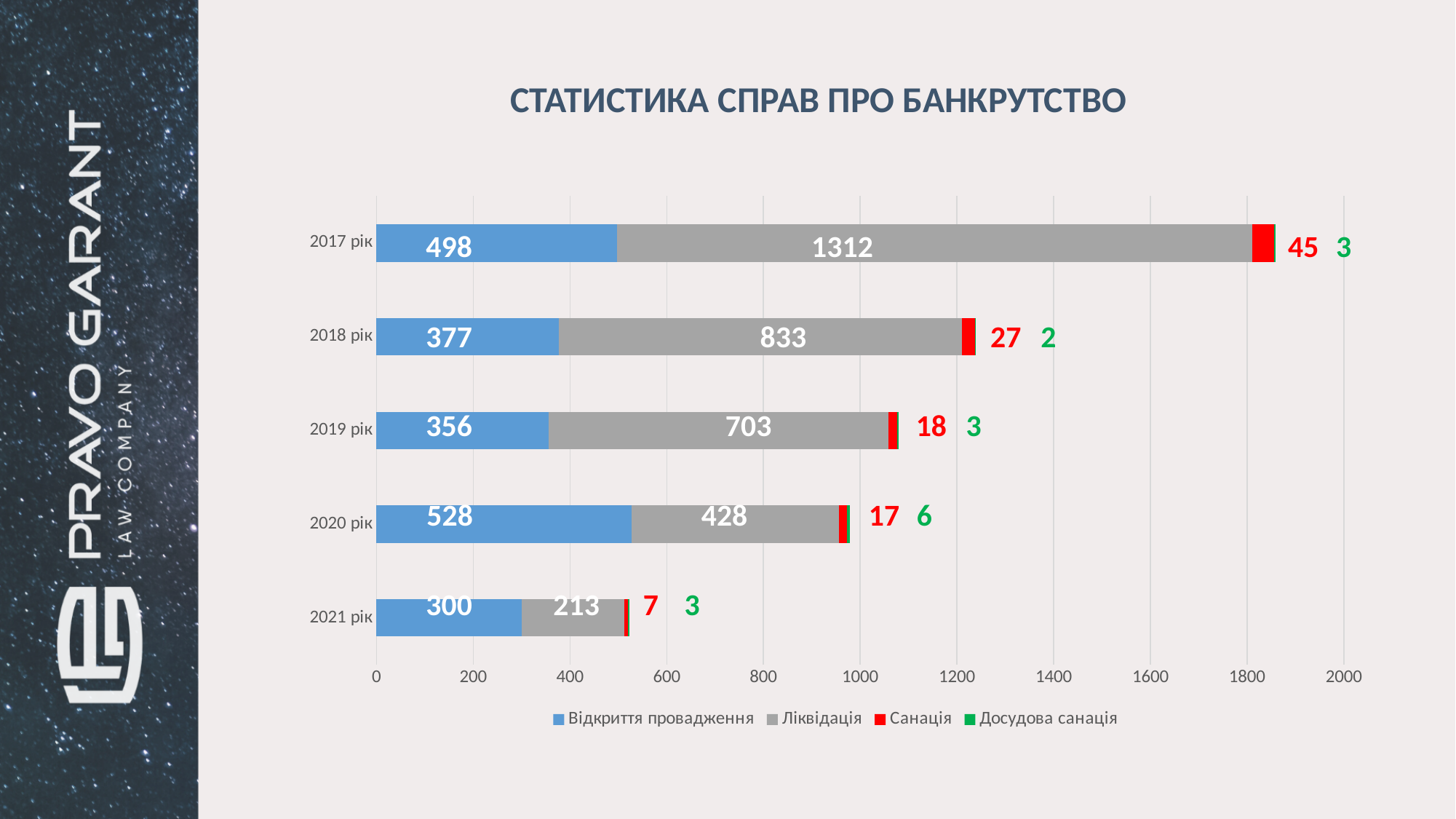
Which year has the highest value for Ліквідація? 2017 рік What is the total of the stacked bar for 2021 рік? 523 How many years are shown on the chart? 5 What is the value of Санація for 2018 рік? 27 Which is larger: Відкриття провадження for 2020 рік or Ліквідація for 2020 рік? Відкриття провадження for 2020 рік What is the value of Досудова санація for 2020 рік? 6 What is the difference between the Ліквідація values for 2018 рік and 2019 рік? 130 Which year has the lowest value for Відкриття провадження? 2021 рік What is the value of Відкриття провадження for 2020 рік? 528 What is the value of Ліквідація for 2017 рік? 1312 How many series does the legend list? 4 What type of chart is shown on the slide? Stacked bar chart